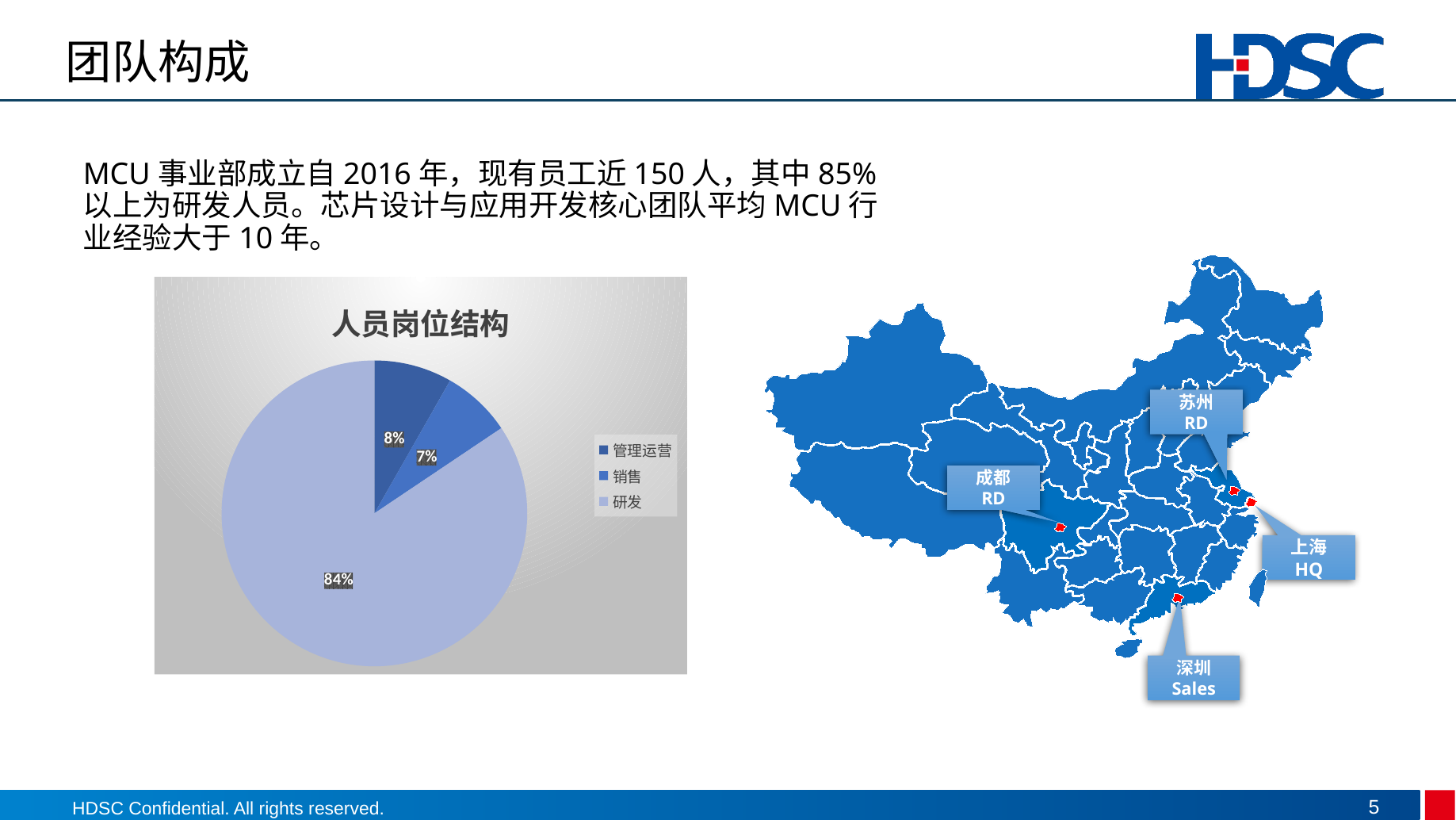
How many categories does the pie chart show? 3 How many entries does the legend of the pie chart list? 3 What is the combined share of 管理运营 and 销售 in the pie chart? 15% Which category has the smallest share of the pie chart? 销售 What kind of chart is shown on the slide? pie chart What percentage of the pie chart is 销售? 7% Which is larger in the pie chart, 管理运营 or 销售? 管理运营 What is the difference in percentage points between 研发 and 管理运营 in the pie chart? 76 What percentage of the pie chart is 研发? 84% What is the title of the pie chart? 人员岗位结构 What percentage of the pie chart is 管理运营? 8% Which category has the largest share of the pie chart? 研发